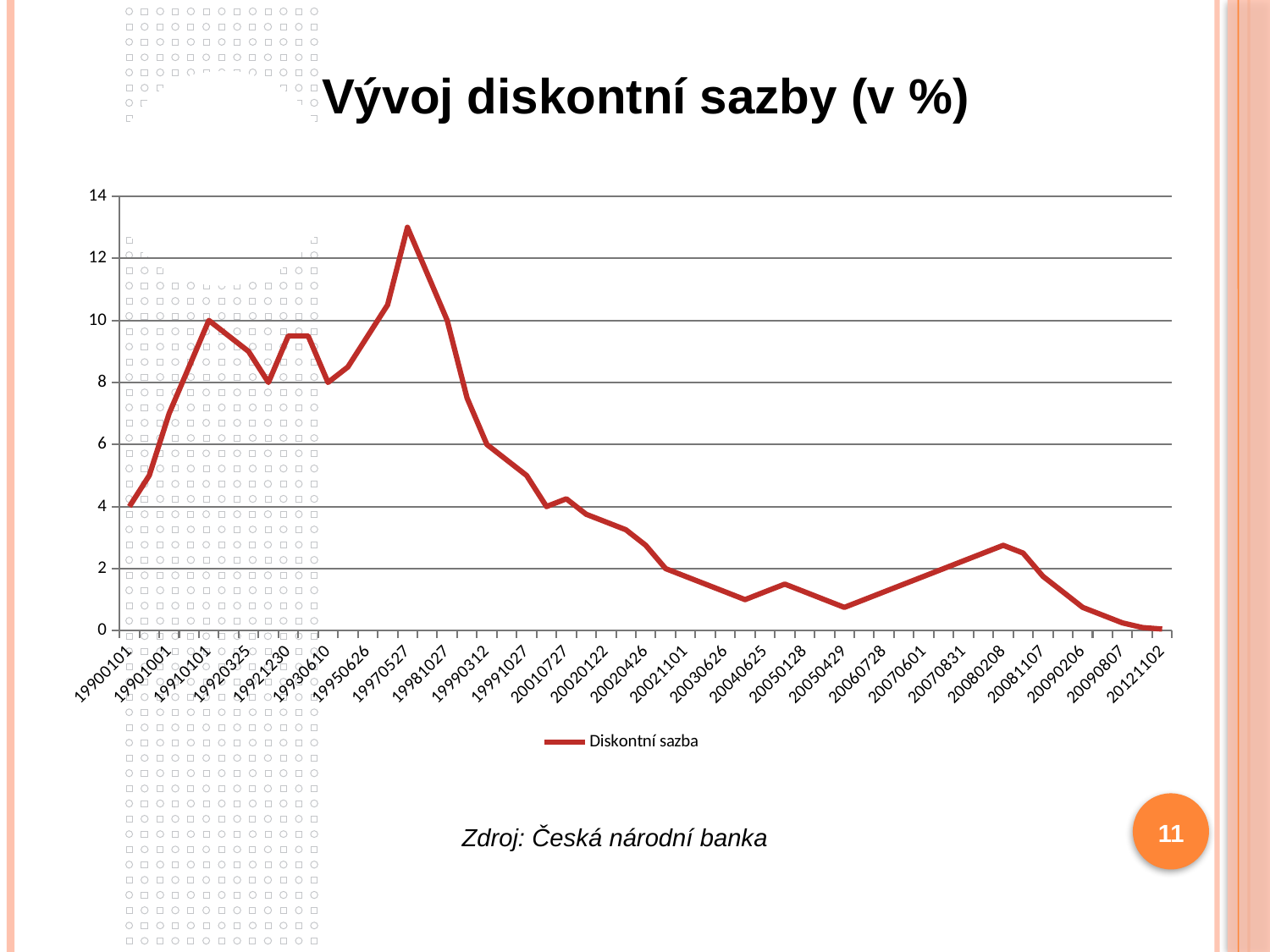
What is the value of the discount rate at 19910101? 10 What is the name of the series shown in the legend? Diskontní sazba What is the value of the discount rate at 19900101? 4 What is the value of the discount rate at 19930610? 8 Does the discount rate rise or fall between 19970527 and 20121102? fall What type of chart is shown on the slide? line chart Is the value for 20040625 greater or less than 2? less Is the value for 19970527 greater or less than 12? greater What is the title of the chart? Vývoj diskontní sazby (v %) At which date does the discount rate reach its highest value? 19970527 How many series does the legend list? 1